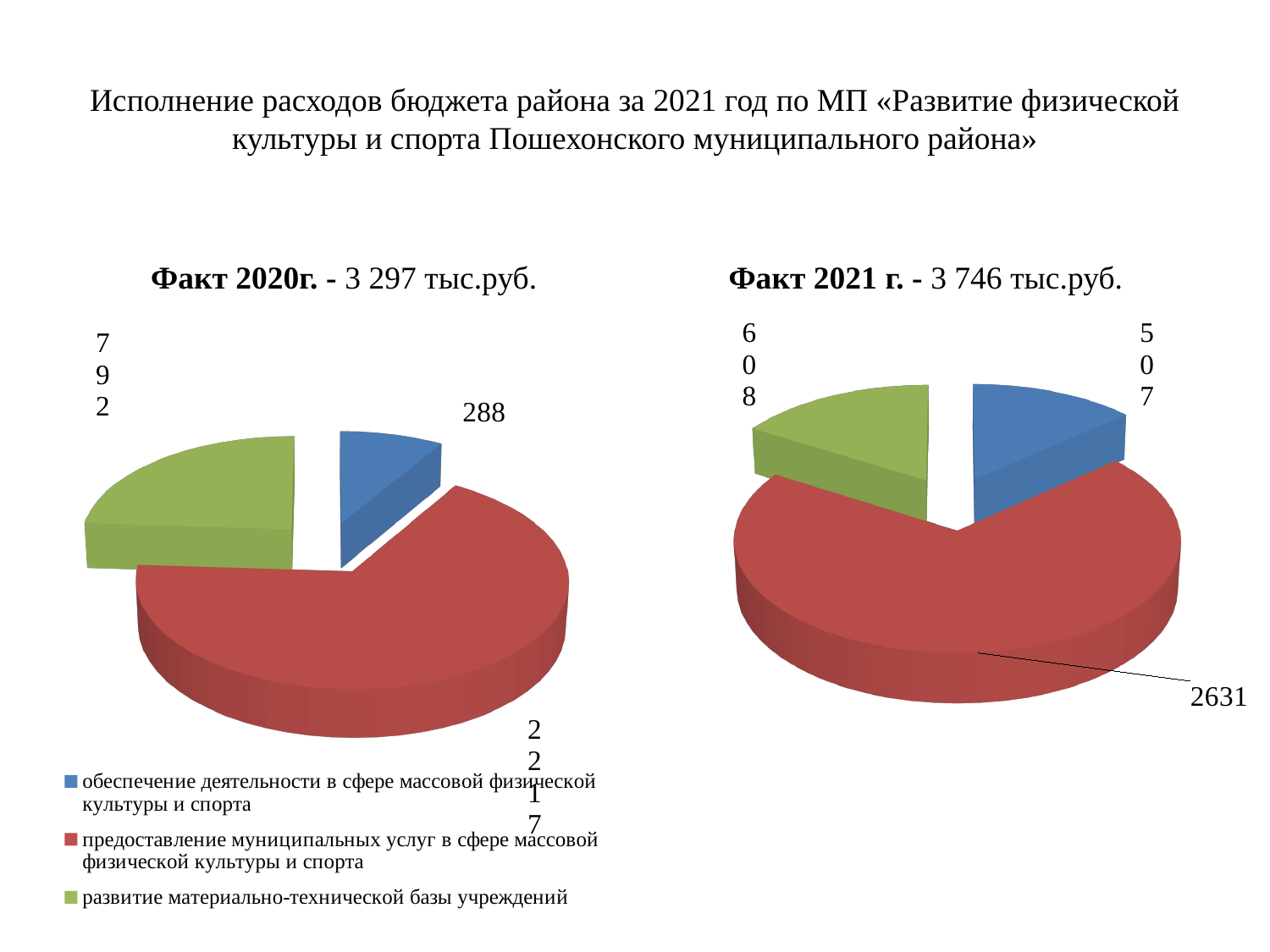
In the left chart (Факт 2020г.), which category has the largest slice? предоставление муниципальных услуг в сфере массовой физической культуры и спорта Which colour represents «развитие материально-технической базы учреждений» in the charts? green How many entries does the legend list? 3 In the right chart (Факт 2021 г.), which category has the smallest slice? обеспечение деятельности в сфере массовой физической культуры и спорта What is the difference between the value for «предоставление муниципальных услуг» in the right chart (2021) and in the left chart (2020)? 414 In the right chart (Факт 2021 г.), what is the value for «развитие материально-технической базы учреждений»? 608 Which is larger: the value for «развитие материально-технической базы учреждений» in the left chart (2020) or in the right chart (2021)? left chart (2020), 792 What kind of chart is used on this slide? pie chart In the left chart (Факт 2020г.), what is the value for «обеспечение деятельности в сфере массовой физической культуры и спорта»? 288 What is the total shown in the title of the right chart (Факт 2021 г.)? 3 746 тыс.руб. In the right chart (Факт 2021 г.), what is the value for «предоставление муниципальных услуг в сфере массовой физической культуры и спорта»? 2631 How many slices does the left chart (Факт 2020г.) have? 3